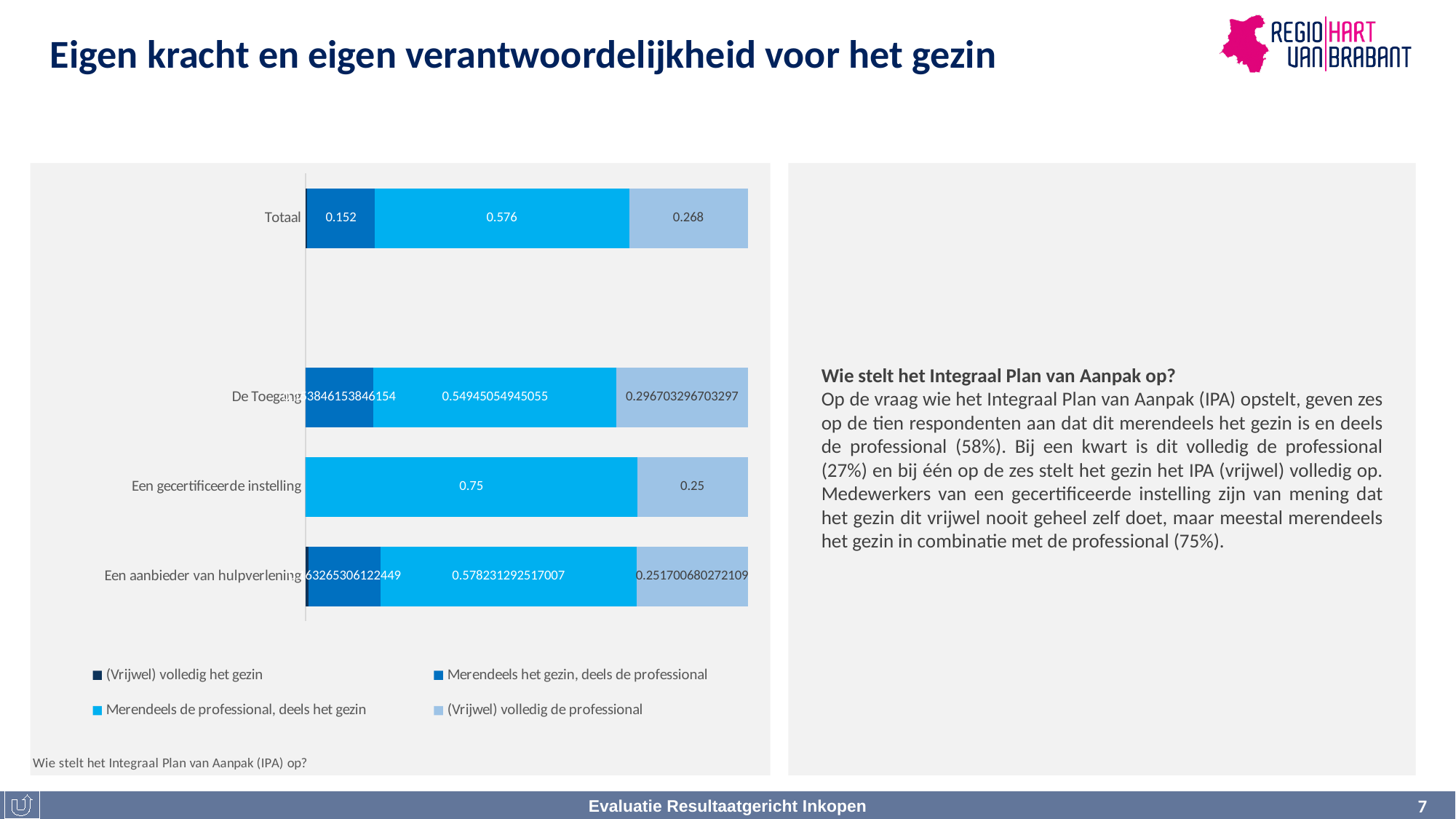
How many series does the chart legend list? 4 What kind of chart is shown on the slide? Stacked bar chart What is the value of '(Vrijwel) volledig de professional' for Een aanbieder van hulpverlening? 0.251700680272109 In the bar for Een gecertificeerde instelling, what is the difference between the two segments (0.75 and 0.25)? 0.5 What is the value of '(Vrijwel) volledig de professional' for Een gecertificeerde instelling? 0.25 Which has the larger value for '(Vrijwel) volledig de professional': Totaal or Een gecertificeerde instelling? Totaal What question is printed below the chart as its caption? Wie stelt het Integraal Plan van Aanpak (IPA) op? How many categories (bars) does the chart show? 4 What is the value of the largest segment in the bar for Een gecertificeerde instelling? 0.75 Which category has the highest value for '(Vrijwel) volledig de professional'? De Toegang What is the value of '(Vrijwel) volledig de professional' for Totaal? 0.268 What is the value of '(Vrijwel) volledig de professional' for De Toegang? 0.296703296703297